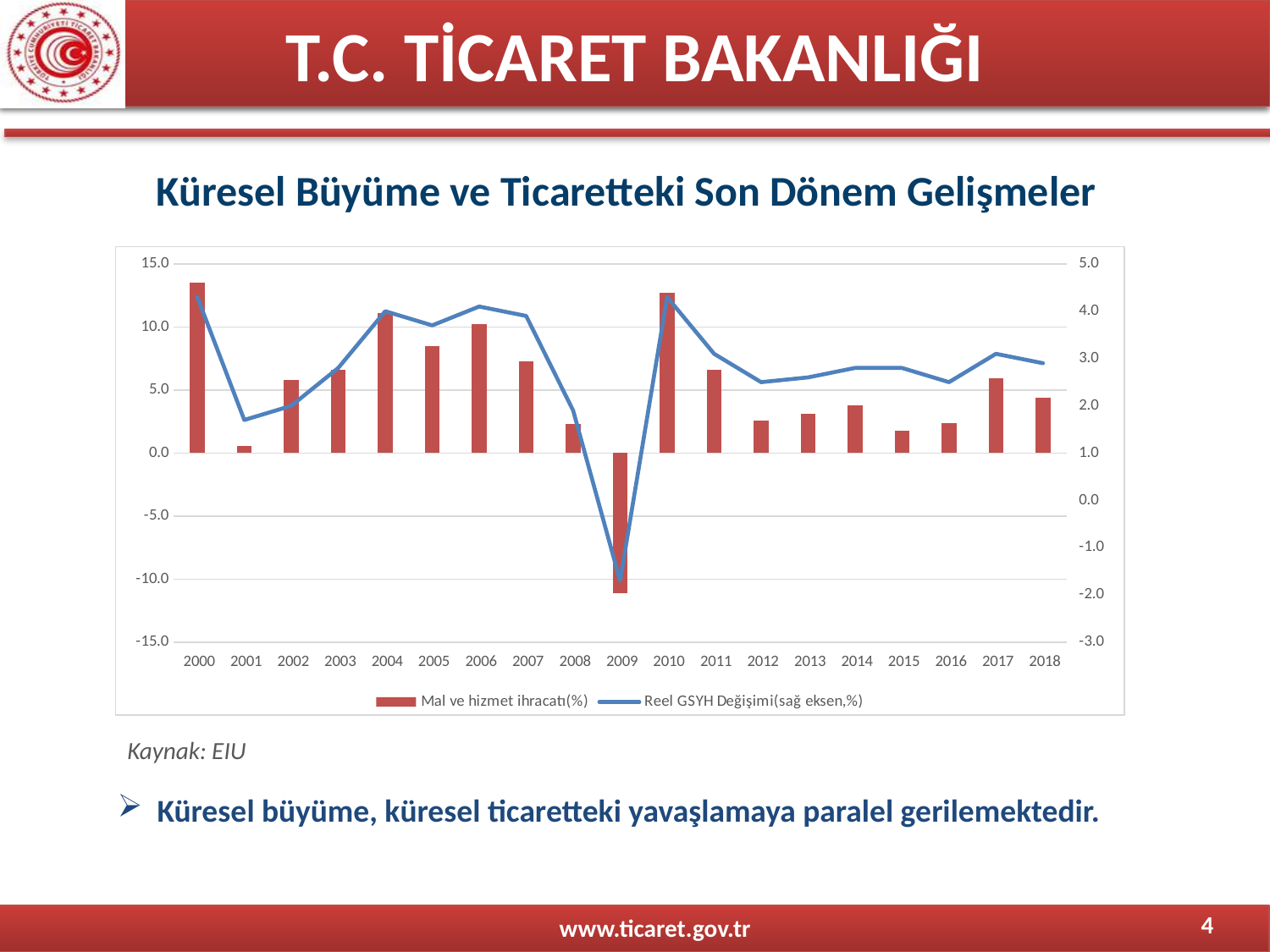
Which year has the lowest value for Mal ve hizmet ihracatı(%)? 2009 Which is larger, the Mal ve hizmet ihracatı(%) bar for 2017 or for 2016? 2017 Is the value for Mal ve hizmet ihracatı(%) in 2015 greater or less than 5.0? less Is the value for Mal ve hizmet ihracatı(%) in 2000 greater or less than 10.0? greater Is the value for Mal ve hizmet ihracatı(%) in 2009 greater or less than -10.0? less How many series does the chart legend list? 2 Which series is plotted on the right-hand axis according to the legend? Reel GSYH Değişimi(sağ eksen,%) Which is larger, the Mal ve hizmet ihracatı(%) bar for 2004 or for 2005? 2004 How many years are shown on the x axis of the chart? 19 What kind of chart is shown on the slide? Combined bar and line chart